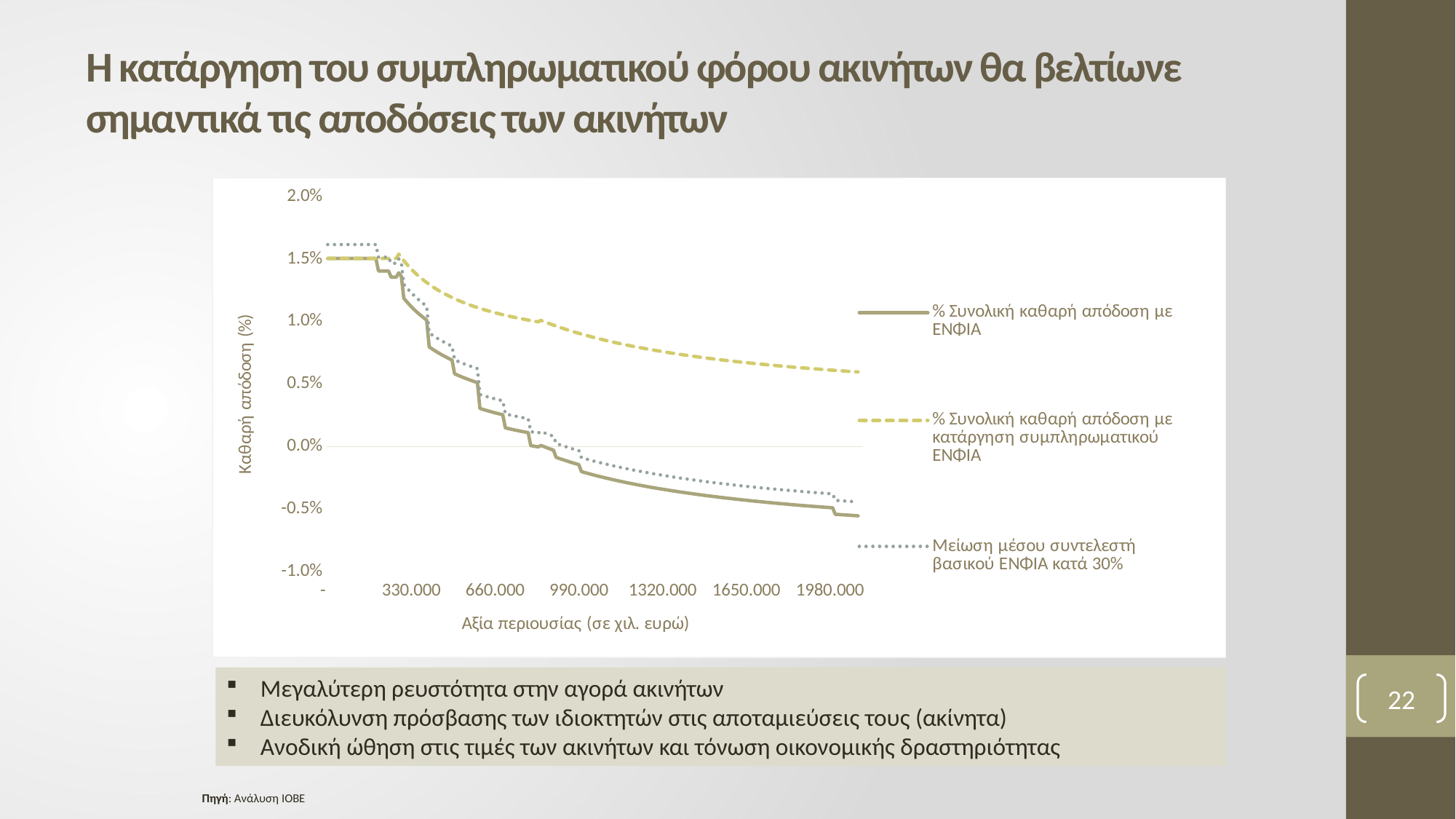
What is the title of the x axis of the chart? Αξία περιουσίας (σε χιλ. ευρώ) At 1980.000, which series has the higher value: '% Συνολική καθαρή απόδοση με ΕΝΦΙΑ' or '% Συνολική καθαρή απόδοση με κατάργηση συμπληρωματικού ΕΝΦΙΑ'? % Συνολική καθαρή απόδοση με κατάργηση συμπληρωματικού ΕΝΦΙΑ Which series has the highest value at 1320.000? % Συνολική καθαρή απόδοση με κατάργηση συμπληρωματικού ΕΝΦΙΑ What is the title of the y axis of the chart? Καθαρή απόδοση (%) Is the value of '% Συνολική καθαρή απόδοση με ΕΝΦΙΑ' at 330.000 greater or less than 1.0%? greater What kind of chart is shown on the slide? Line chart How many series does the legend list? 3 Is the value of 'Μείωση μέσου συντελεστή βασικού ΕΝΦΙΑ κατά 30%' at 1980.000 greater or less than 0.0%? less Is the value of '% Συνολική καθαρή απόδοση με ΕΝΦΙΑ' at 1980.000 greater or less than 0.0%? less Do the values of the series '% Συνολική καθαρή απόδοση με ΕΝΦΙΑ' rise or fall as property value increases along the x axis? Fall Do the values of the series '% Συνολική καθαρή απόδοση με κατάργηση συμπληρωματικού ΕΝΦΙΑ' rise or fall along the x axis? Fall